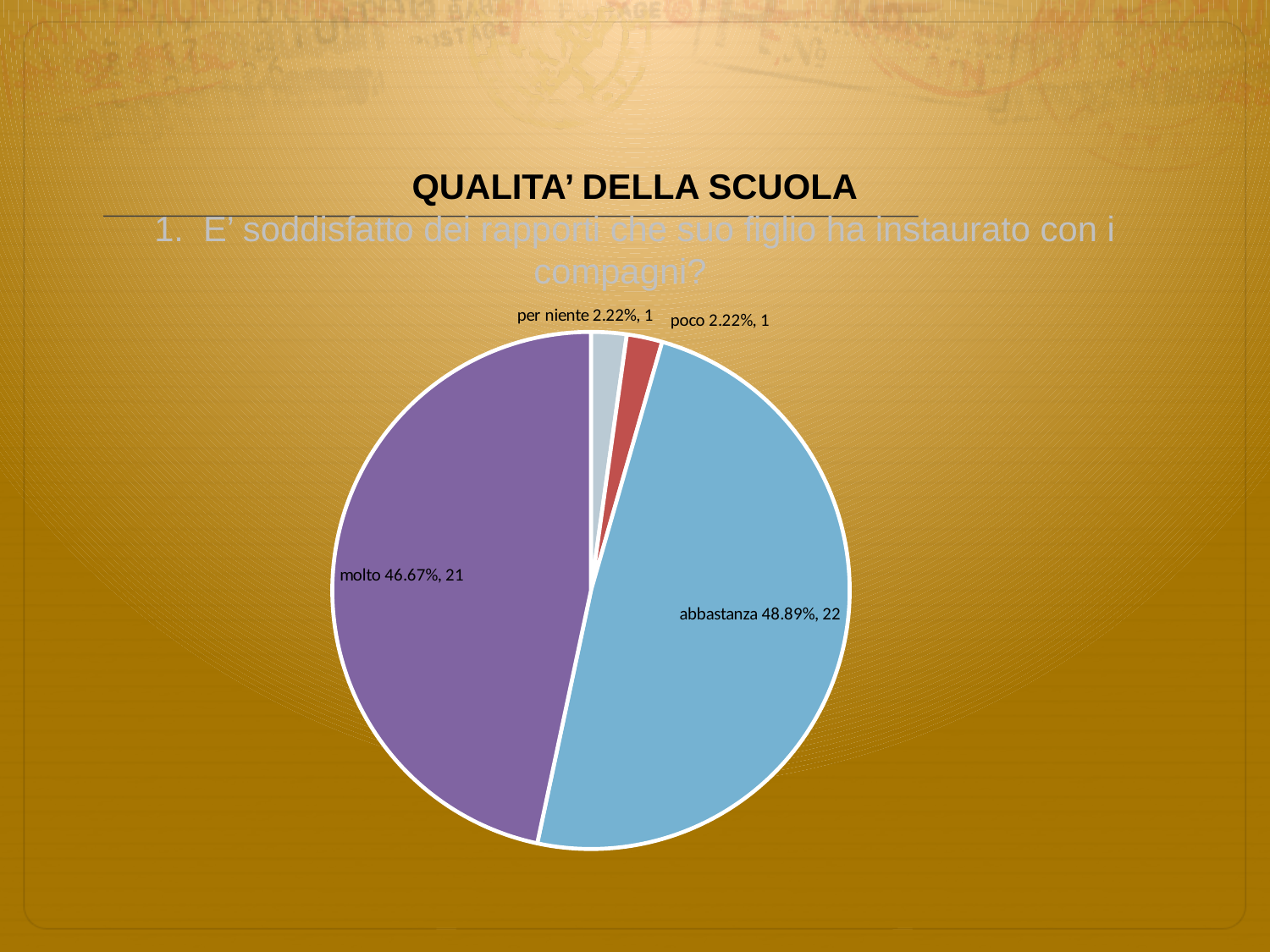
What percentage share does the 'poco' slice have? 2.22% How many slices does the pie chart have? 4 Which category has the largest share of the pie? abbastanza What percentage share does the 'abbastanza' slice have? 48.89% How many responses does the 'abbastanza' slice represent? 22 How many responses does the 'per niente' slice represent? 1 How many responses does the 'molto' slice represent? 21 What is the title shown above the chart on the slide? QUALITA' DELLA SCUOLA What kind of chart is shown on the slide? pie chart What percentage share does the 'molto' slice have? 46.67% Which is larger, the count for 'abbastanza' or the count for 'molto'? abbastanza What is the difference between the counts for 'abbastanza' and 'molto'? 1